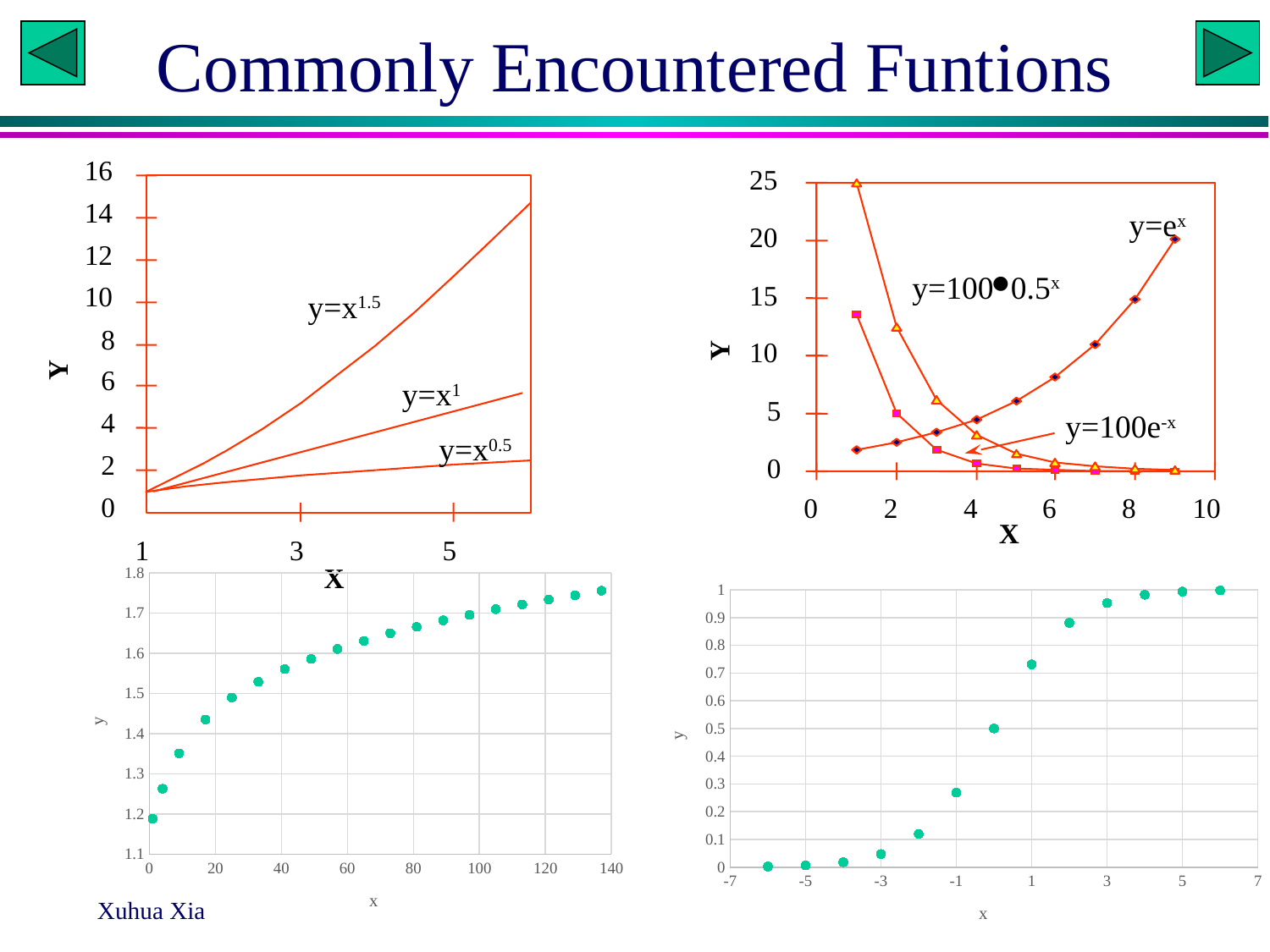
On the top-right chart, do the values of y=100e^-x rise or fall as x increases? fall What kind of chart is the top-left chart? line chart On the bottom-right chart, is the value at x=1 greater or less than 0.6? greater How many curves are plotted on the top-left chart? 3 On the top-left chart, is the value of y=x^0.5 at x=5 greater or less than 4? less How many points are plotted on the bottom-right chart? 13 On the top-left chart, is the value of y=x^1.5 at x=5 greater or less than 8? greater On the bottom-right chart, do the values rise or fall as x increases? rise How many curves are plotted on the top-right chart? 3 What kind of chart is the bottom-left chart? scatter chart On the top-right chart, at x=1, which is larger: y=100•0.5^x or y=100e^-x? y=100•0.5^x